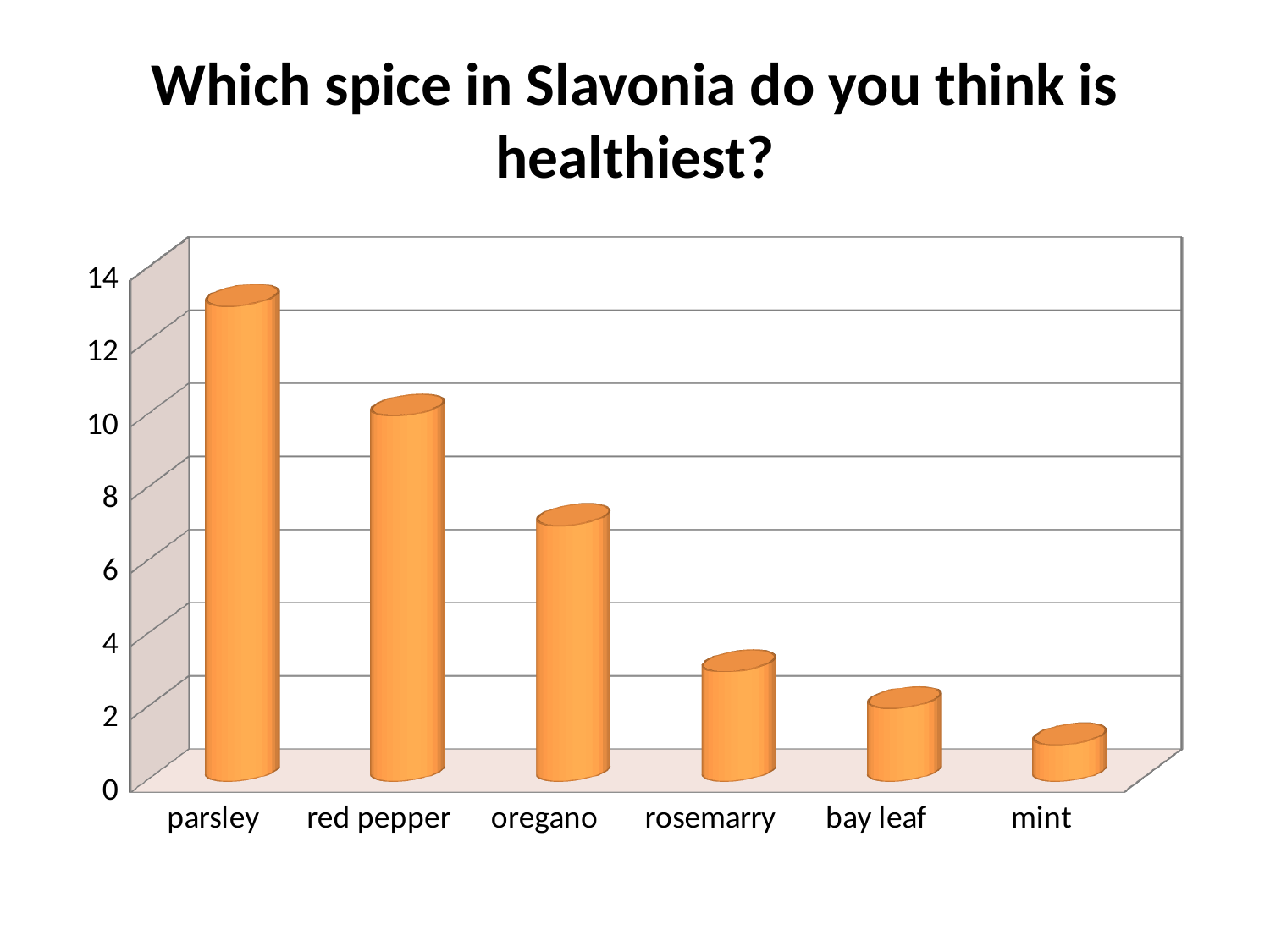
Is the value for parsley greater or less than 12? greater Which spice has the lowest bar? mint How many spices are shown on the x axis of the chart? 6 Which spice has the highest bar? parsley Is the value for rosemarry greater or less than 4? less Which has a larger value, red pepper or oregano? red pepper What kind of chart is shown on the slide? bar chart Is the value for red pepper greater or less than 8? greater What is the title of the chart? Which spice in Slavonia do you think is healthiest? Do the values rise or fall moving from parsley to mint along the x axis? fall